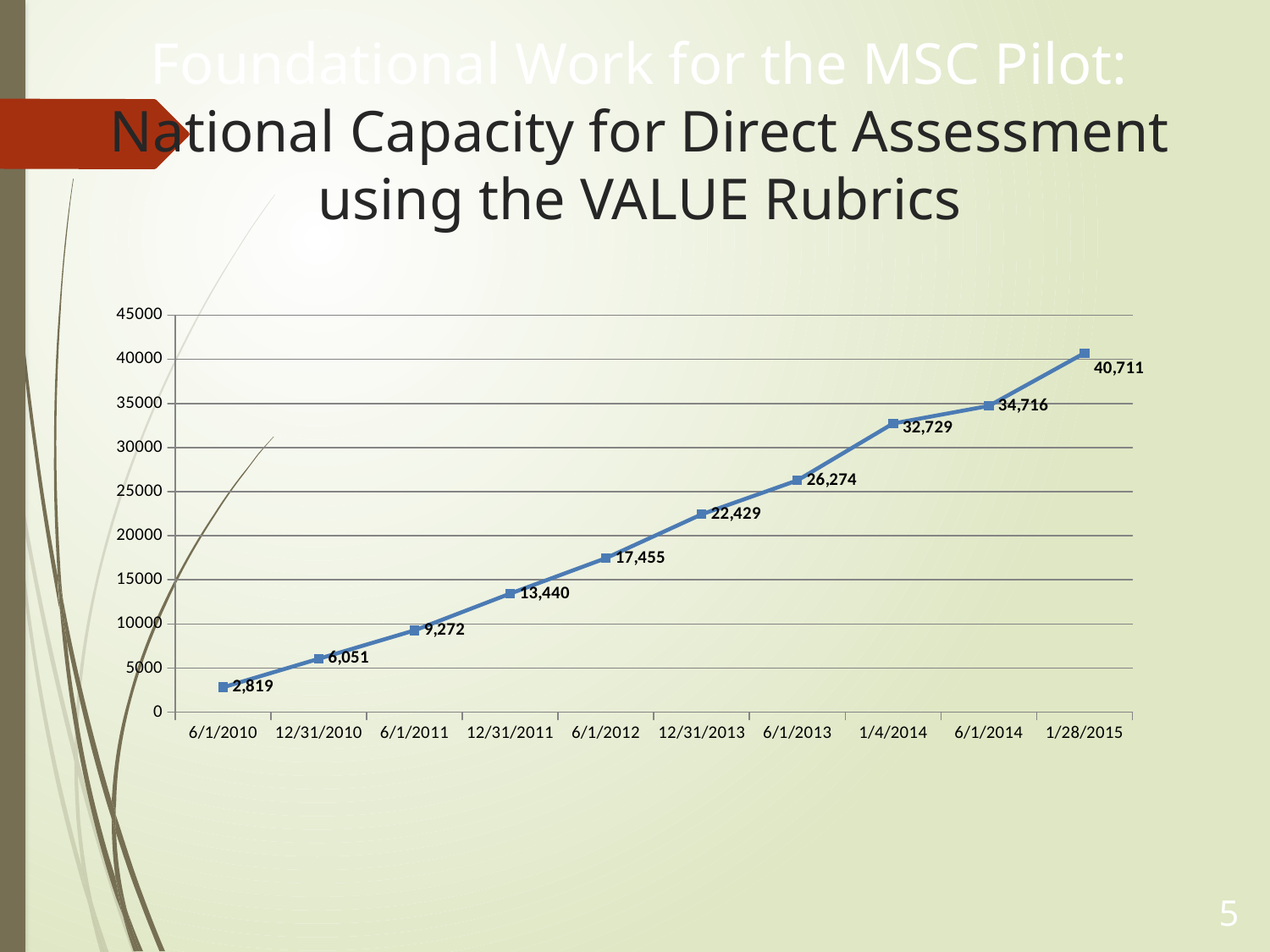
What is the difference between the values for 1/4/2014 and 6/1/2013? 6,455 What is the value plotted for 1/4/2014? 32,729 Which date has the highest plotted value? 1/28/2015 Do the plotted values rise or fall from 6/1/2010 to 1/28/2015? Rise Which is larger, the value for 6/1/2012 or the value for 12/31/2013? 12/31/2013 Which date has the lowest plotted value? 6/1/2010 How many data points are plotted on the chart? 10 What is the value plotted for 12/31/2011? 13,440 Is the value for 6/1/2014 greater or less than 30000? greater What is the difference between the values for 1/28/2015 and 6/1/2010? 37,892 What kind of chart is shown on the slide? Line chart What is the value plotted for 6/1/2010? 2,819